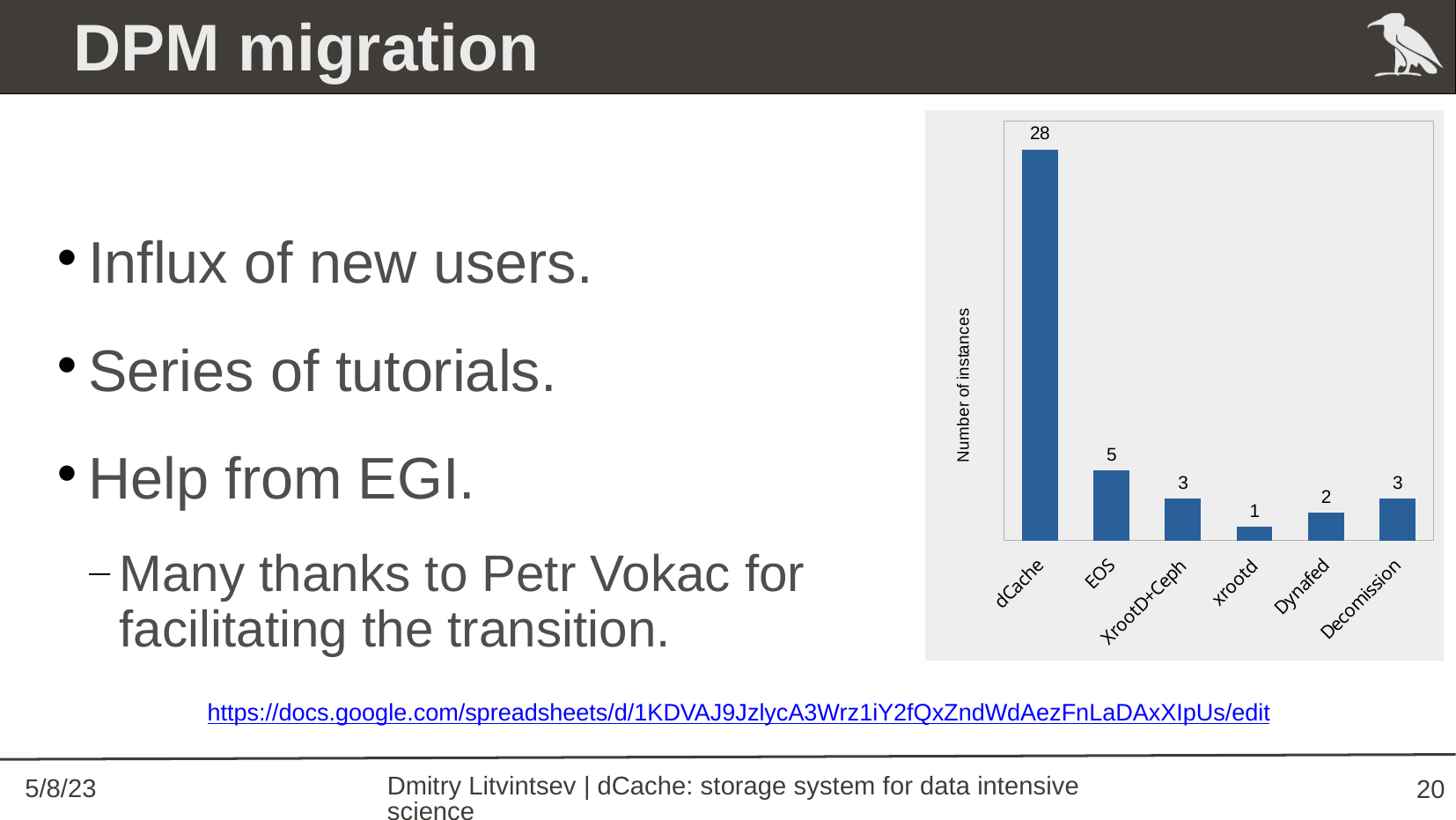
What is the difference in number of instances between dCache and EOS? 23 What kind of chart is shown on the slide? Bar chart What is the number of instances for Dynafed? 2 Which has more instances, EOS or Dynafed? EOS What is the number of instances for EOS? 5 What is the label of the vertical axis of the chart? Number of instances How many categories are shown on the x axis of the chart? 6 Which category has the highest number of instances? dCache What is the number of instances for xrootd? 1 What is the number of instances for XrootD+Ceph? 3 Which category has the lowest number of instances? xrootd What is the number of instances for dCache? 28